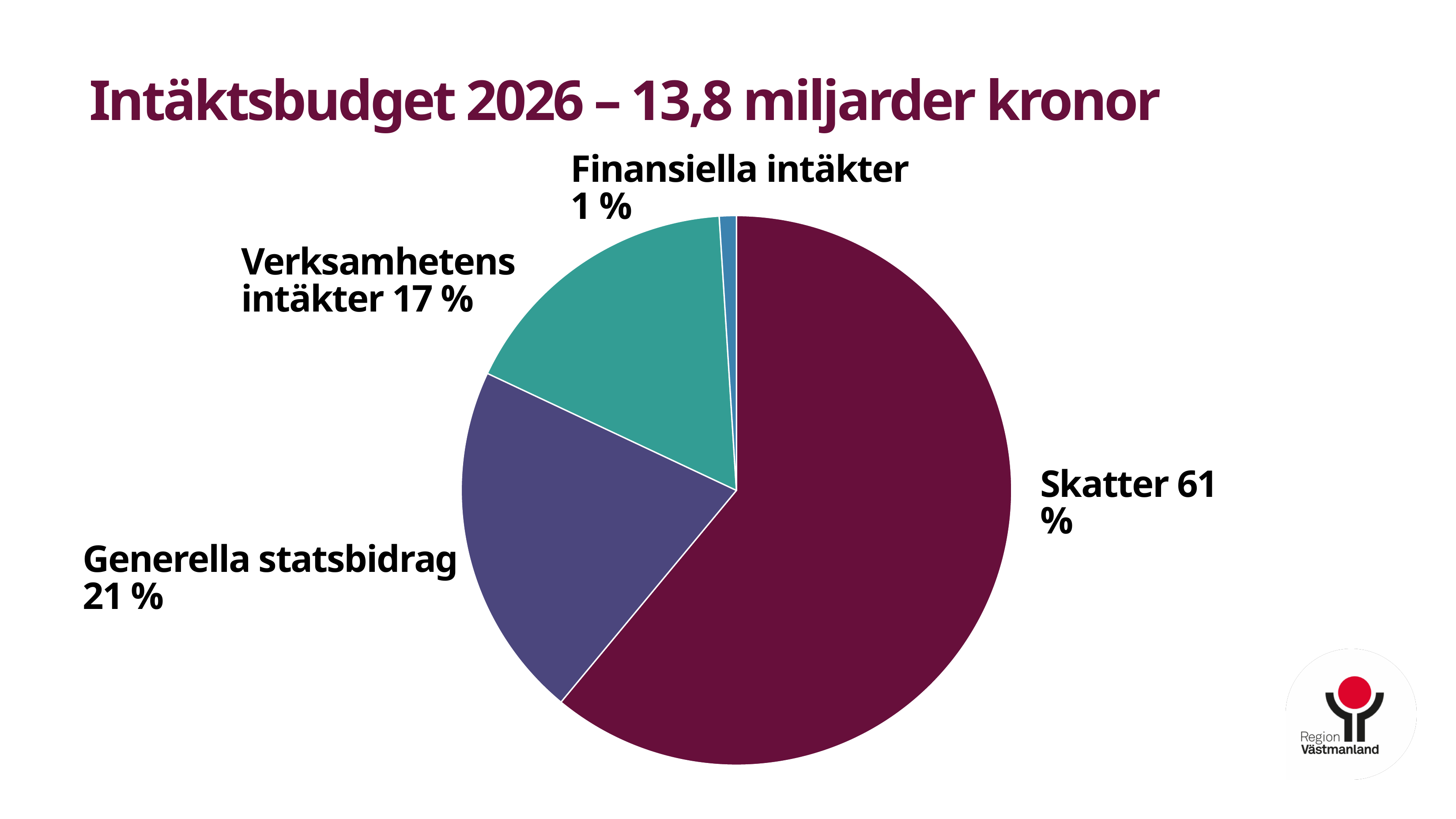
What share of the pie does Generella statsbidrag represent? 21 % What share of the pie does Finansiella intäkter represent? 1 % What share of the pie does Verksamhetens intäkter represent? 17 % Which category has the largest slice of the pie? Skatter What kind of chart is shown on the slide? pie chart What colour is the Skatter slice? dark red What is the difference in percentage points between Skatter and Generella statsbidrag? 40 What is the title of the chart on the slide? Intäktsbudget 2026 – 13,8 miljarder kronor Which category has the smallest slice of the pie? Finansiella intäkter How many slices does the pie chart have? 4 Which is larger, Generella statsbidrag or Verksamhetens intäkter? Generella statsbidrag